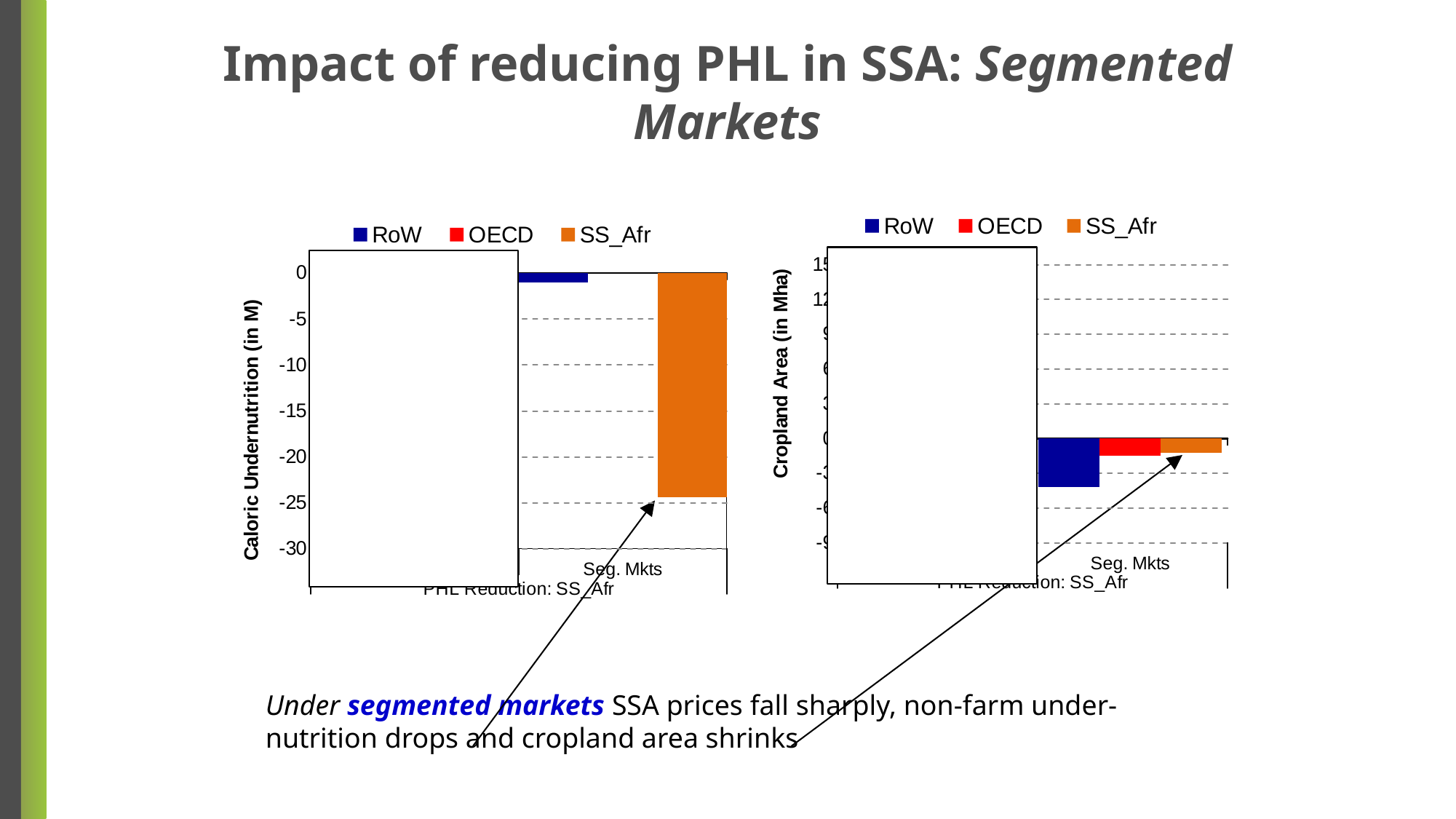
On the left chart (Caloric Undernutrition), which series has the lowest (most negative) value? SS_Afr On the right chart (Cropland Area), which is lower, the value for RoW or the value for OECD? RoW What is the y-axis title of the right chart? Cropland Area (in Mha) On the right chart (Cropland Area), which series has the lowest (most negative) value? RoW On the right chart (Cropland Area), is the value for RoW greater or less than 0? less On the right chart (Cropland Area), is the value for OECD greater or less than -3? greater What is the y-axis title of the left chart? Caloric Undernutrition (in M) On the right chart (Cropland Area), what kind of chart is shown? bar chart On the left chart (Caloric Undernutrition), how many series does the legend list? 3 On the left chart (Caloric Undernutrition), is the value for RoW greater or less than -5? greater On the left chart (Caloric Undernutrition), which is lower, the value for RoW or the value for SS_Afr? SS_Afr